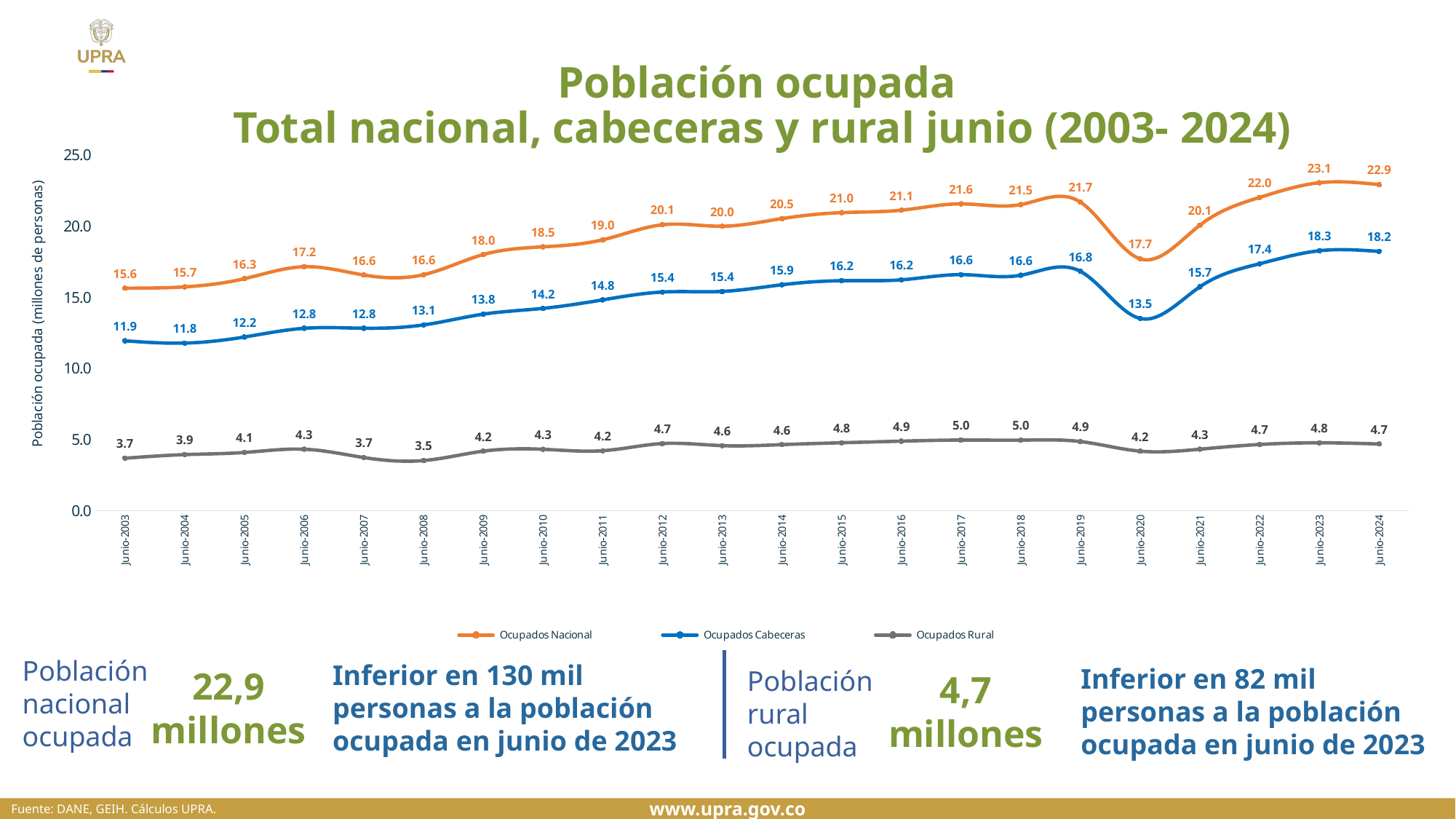
What is the value of Ocupados Nacional in Junio-2024? 22.9 In which year does Ocupados Nacional reach its highest value? Junio-2023 Which colour is used for the Ocupados Rural series? Grey What kind of chart is shown on the slide? Line chart What is the value of Ocupados Rural in Junio-2008? 3.5 How many years (data points) are plotted on the x axis? 22 What is the difference between Ocupados Nacional and Ocupados Cabeceras in Junio-2024? 4.7 What is the value of Ocupados Cabeceras in Junio-2020? 13.5 Which is larger: Ocupados Nacional in Junio-2019 or in Junio-2020? Junio-2019 In which year is Ocupados Cabeceras at its lowest value? Junio-2004 What is the difference between Ocupados Nacional in Junio-2023 and Junio-2024? 0.2 How many series does the legend list? 3